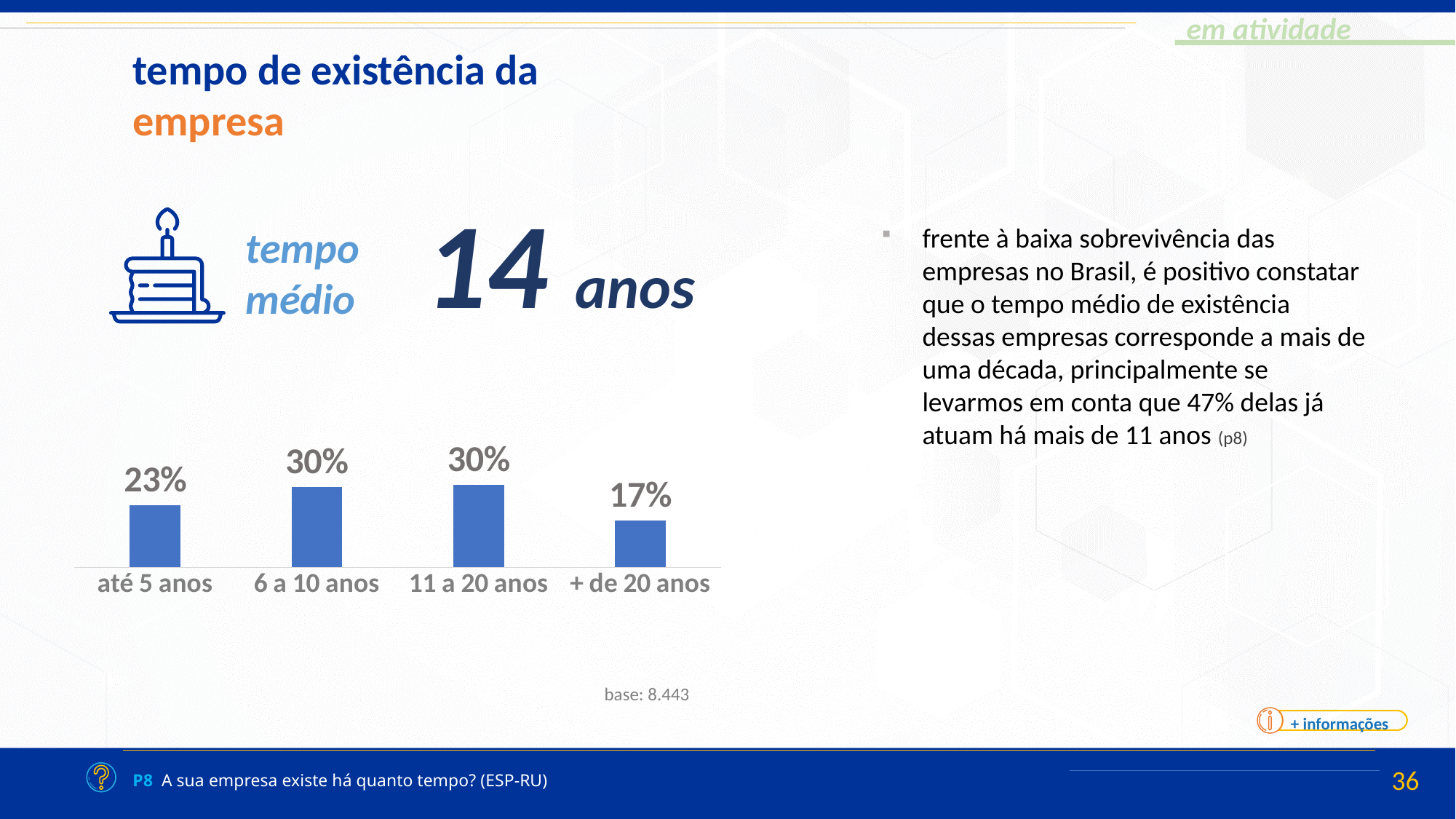
What is the value for the '11 a 20 anos' category? 30% What is the value for the '+ de 20 anos' category? 17% What kind of chart is shown on the slide? bar chart Which category has the lowest value? + de 20 anos Which is larger, the value for 'até 5 anos' or the value for '6 a 10 anos'? 6 a 10 anos What is the base (sample size) noted below the chart? 8.443 Which is larger, the value for '11 a 20 anos' or the value for '+ de 20 anos'? 11 a 20 anos What is the difference between the values for 'até 5 anos' and '+ de 20 anos'? 6% What is the value for the 'até 5 anos' category? 23% How many categories are shown in the chart? 4 What is the value for the '6 a 10 anos' category? 30% What is the difference between the values for '6 a 10 anos' and '+ de 20 anos'? 13%